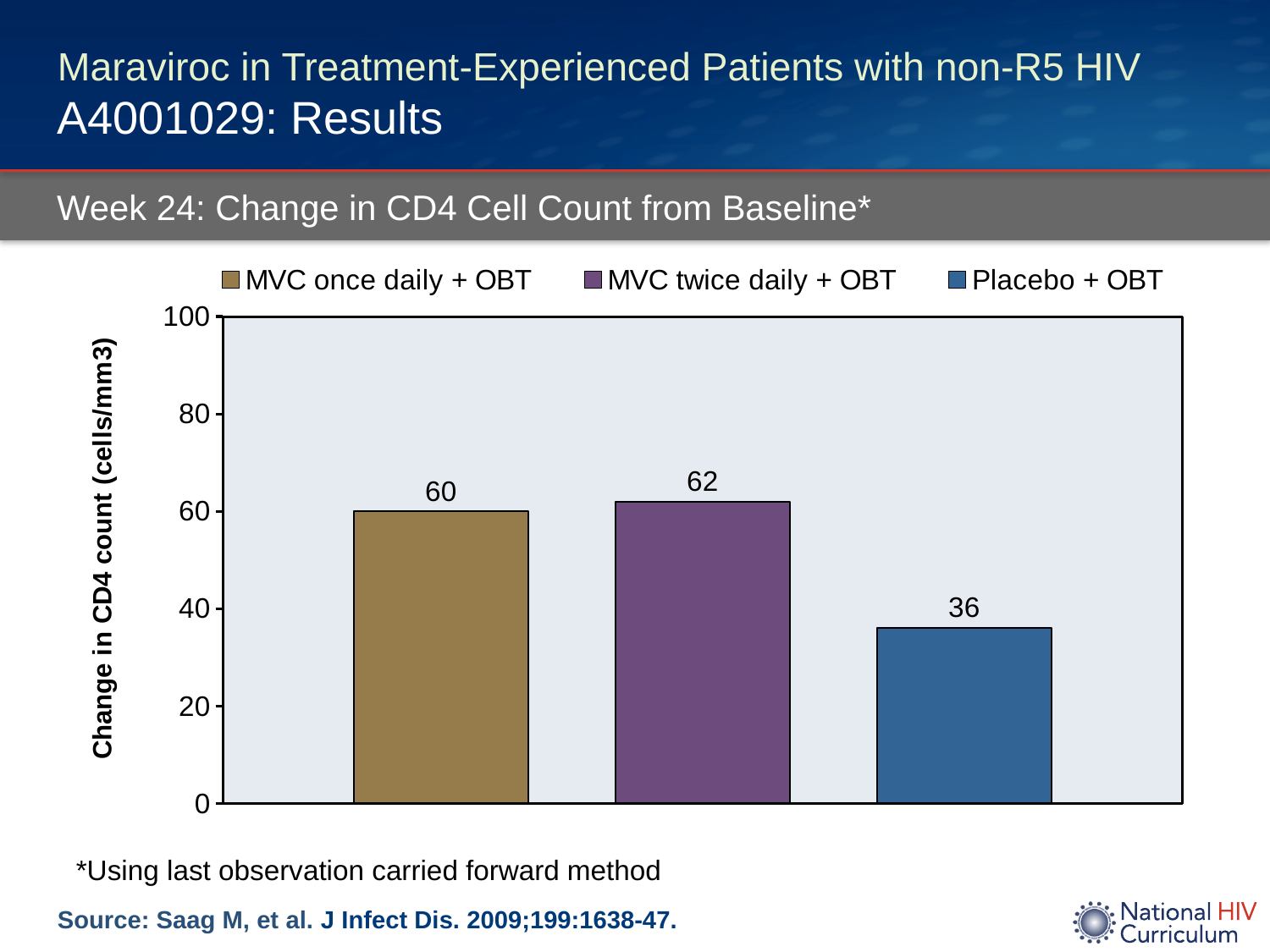
What is the difference in CD4 count change between MVC once daily + OBT and Placebo + OBT? 24 What is the change in CD4 count for MVC once daily + OBT? 60 What kind of chart is shown on the slide? Bar chart What is the change in CD4 count for MVC twice daily + OBT? 62 What is the label of the y axis? Change in CD4 count (cells/mm3) Which group has the highest change in CD4 count? MVC twice daily + OBT Which group has the lowest change in CD4 count? Placebo + OBT Which is larger, the change in CD4 count for MVC once daily + OBT or for Placebo + OBT? MVC once daily + OBT What is the difference in CD4 count change between MVC twice daily + OBT and Placebo + OBT? 26 Is the value for Placebo + OBT greater or less than 40? less How many series does the legend list? 3 What is the change in CD4 count for Placebo + OBT? 36